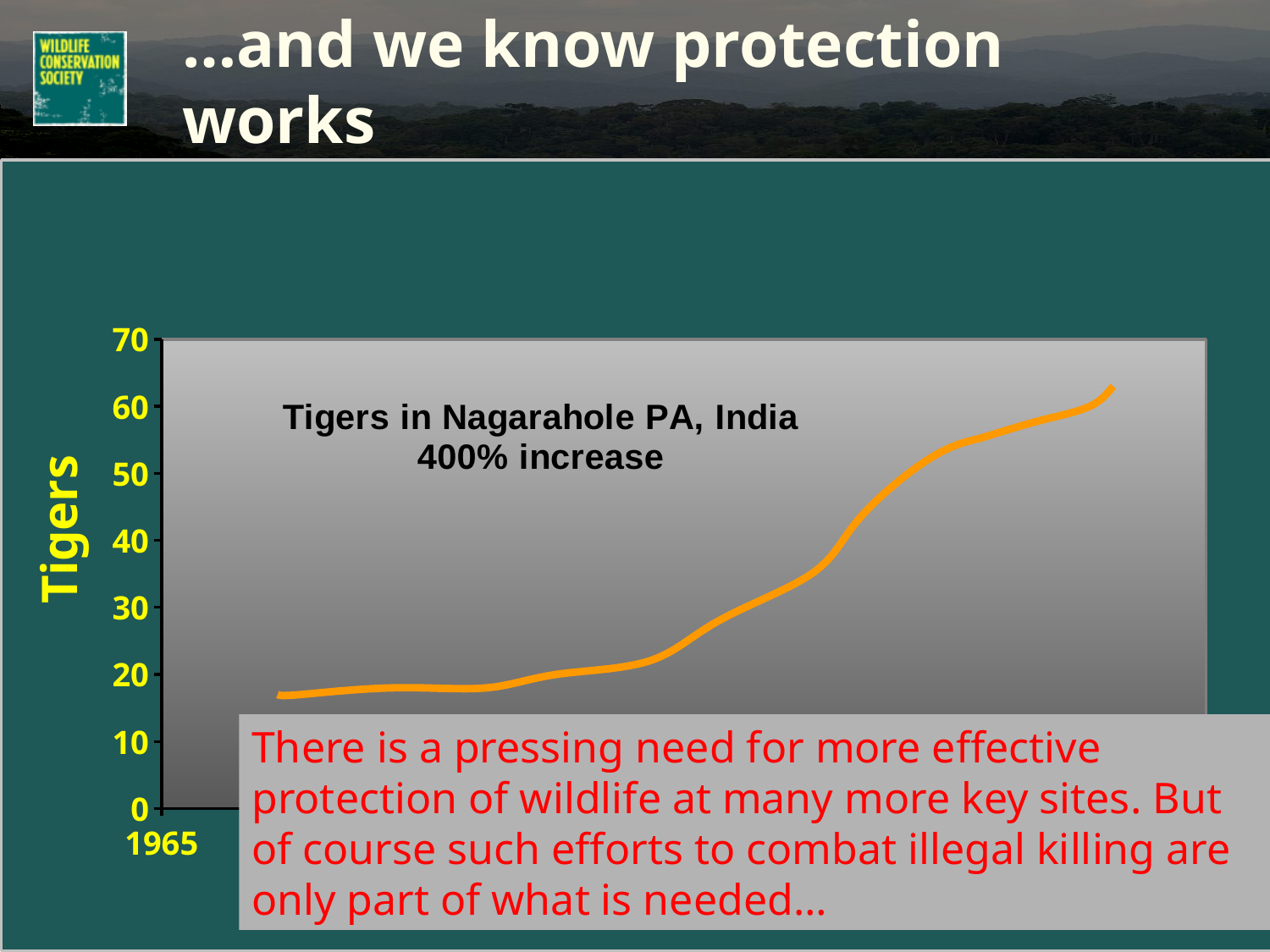
What is the first year label shown on the x axis? 1965 Is the value at the left-hand start of the line greater or less than 20? less What is the label on the y axis of the chart? Tigers Is the value at the right-hand end of the line greater or less than 60? greater Is the lowest value on the line greater or less than 10? greater What kind of chart is shown on the slide? line chart Which end of the line is higher, the left end or the right end? the right end What percentage increase does the chart title state for tigers in Nagarahole PA? 400% What is the title printed inside the chart area? Tigers in Nagarahole PA, India 400% increase What is the highest tick value shown on the y axis? 70 Do the values in the chart rise or fall from left to right along the x axis? rise